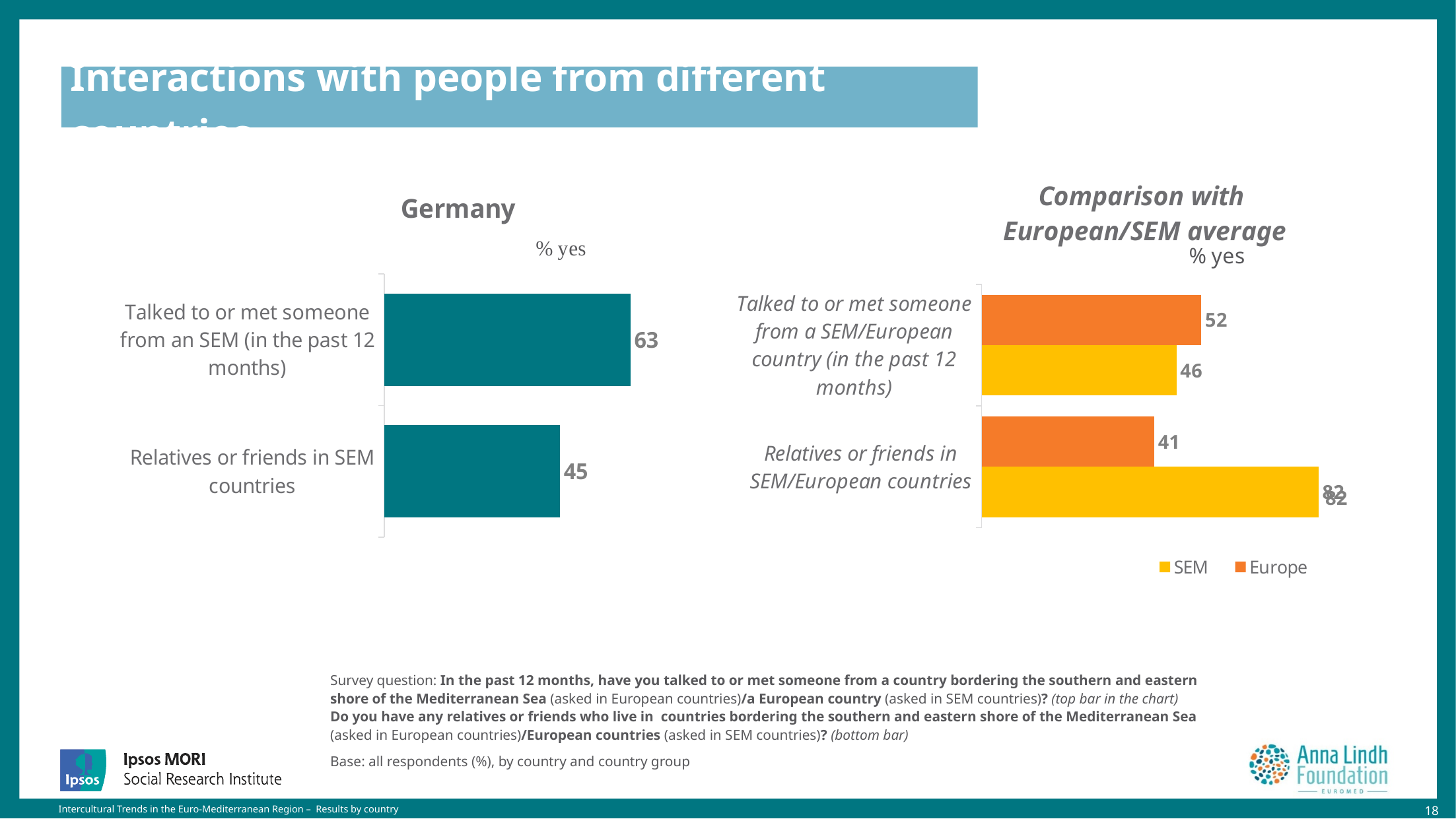
In the Comparison with European/SEM average chart, what is the Europe value for relatives or friends in SEM/European countries? 41 In the Comparison with European/SEM average chart, for talked to or met someone, which is larger: Europe or SEM? Europe In the Germany chart, what percentage have relatives or friends in SEM countries? 45 In the Germany chart, what is the difference between the two bars? 18 In the Comparison with European/SEM average chart, what is the SEM value for talked to or met someone from a SEM/European country? 46 In the Germany chart, which category has the higher value? Talked to or met someone from an SEM (in the past 12 months) In the Comparison with European/SEM average chart, which colour represents SEM? Yellow In the Comparison with European/SEM average chart, what is the Europe value for talked to or met someone from a SEM/European country? 52 What type of chart is the Germany chart? Bar chart In the Comparison with European/SEM average chart, how many series does the legend list? 2 In the Germany chart, how many categories are shown? 2 In the Germany chart, what percentage talked to or met someone from an SEM country in the past 12 months? 63